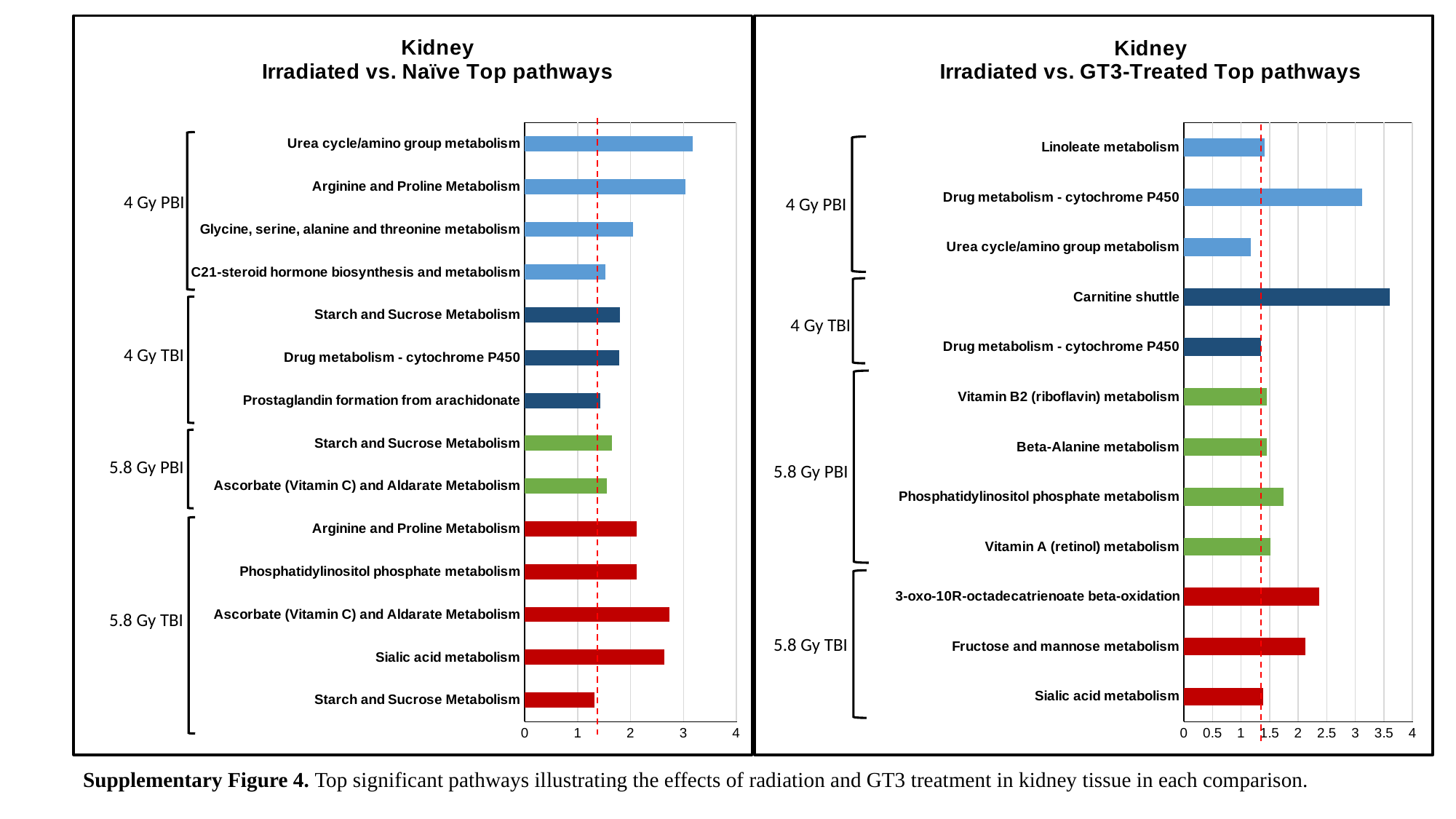
In the right chart, 'Kidney Irradiated vs. GT3-Treated Top pathways', which is larger: Carnitine shuttle or Sialic acid metabolism? Carnitine shuttle In the right chart, 'Kidney Irradiated vs. GT3-Treated Top pathways', which pathway has the highest value? Carnitine shuttle In the right chart, 'Kidney Irradiated vs. GT3-Treated Top pathways', which pathway has the lowest value? Urea cycle/amino group metabolism In the right chart, 'Kidney Irradiated vs. GT3-Treated Top pathways', is the value for Carnitine shuttle greater or less than 3? greater In the left chart, 'Kidney Irradiated vs. Naïve Top pathways', is the value for Urea cycle/amino group metabolism greater or less than 3? greater How many pathway bars are plotted in the left chart, 'Kidney Irradiated vs. Naïve Top pathways'? 14 In the right chart, 'Kidney Irradiated vs. GT3-Treated Top pathways', is the value for Urea cycle/amino group metabolism greater or less than 1.5? less How many pathway bars are plotted in the right chart, 'Kidney Irradiated vs. GT3-Treated Top pathways'? 12 What is the title of the right chart? Kidney Irradiated vs. GT3-Treated Top pathways In the left chart, 'Kidney Irradiated vs. Naïve Top pathways', which is larger in the 5.8 Gy TBI group: Ascorbate (Vitamin C) and Aldarate Metabolism or Starch and Sucrose Metabolism? Ascorbate (Vitamin C) and Aldarate Metabolism What kind of chart is the left chart, 'Kidney Irradiated vs. Naïve Top pathways'? Bar chart